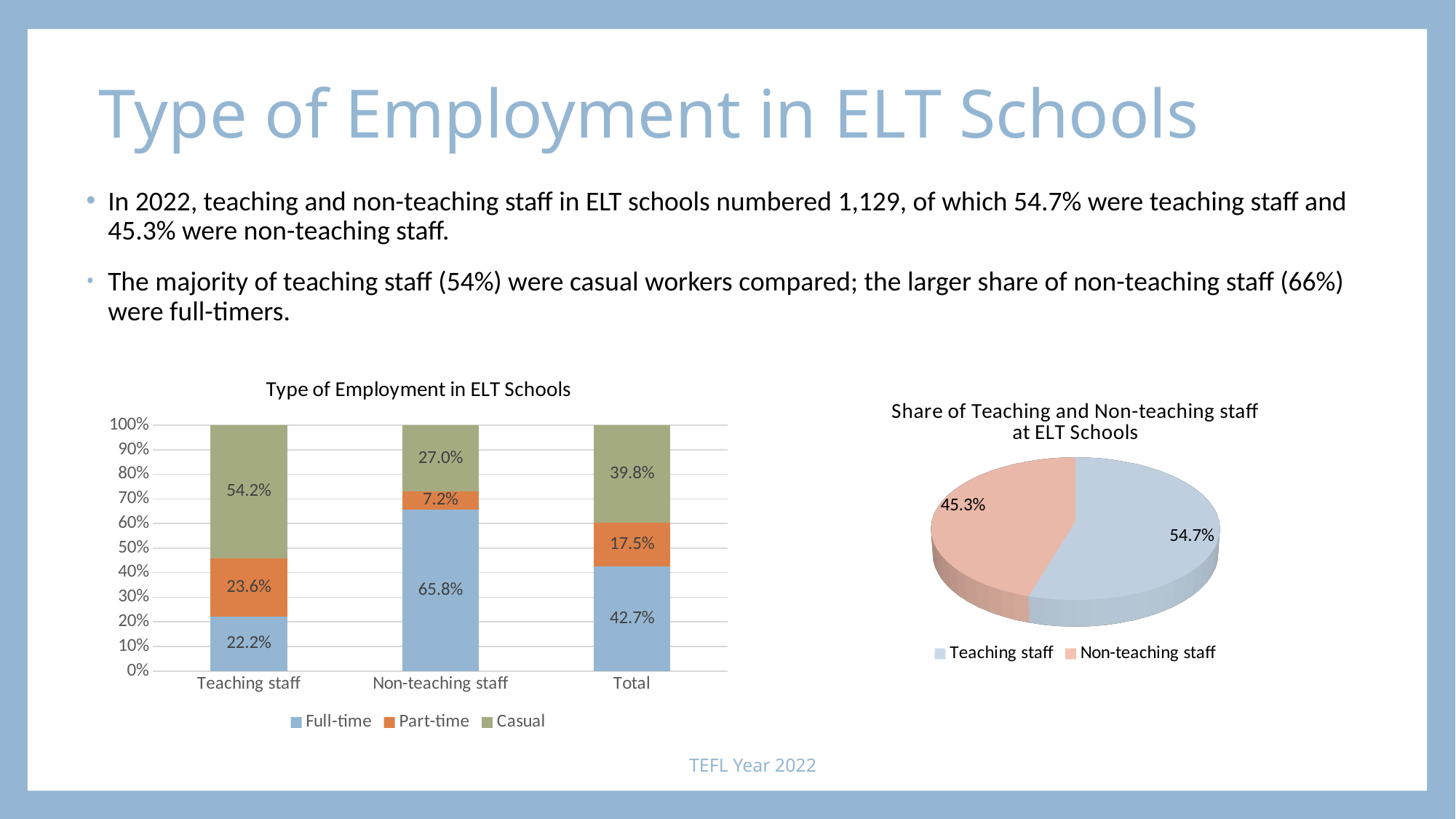
In the 'Type of Employment in ELT Schools' chart, what is the difference between the Casual share for Teaching staff and for Non-teaching staff? 27.2% What kind of chart is 'Share of Teaching and Non-teaching staff at ELT Schools'? Pie chart How many series does the legend of the 'Type of Employment in ELT Schools' chart list? 3 In the 'Type of Employment in ELT Schools' chart, what is the Part-time share for Total? 17.5% In the 'Share of Teaching and Non-teaching staff at ELT Schools' chart, what share is Non-teaching staff? 45.3% In the 'Type of Employment in ELT Schools' chart, what is the Full-time share for Non-teaching staff? 65.8% In the 'Type of Employment in ELT Schools' chart, which category has the highest Full-time share? Non-teaching staff In the 'Type of Employment in ELT Schools' chart, which category has the lowest Part-time share? Non-teaching staff How many categories are shown on the x axis of the 'Type of Employment in ELT Schools' chart? 3 In the 'Type of Employment in ELT Schools' chart, is the Full-time share larger for Teaching staff or for Total? Total In the 'Type of Employment in ELT Schools' chart, what is the Casual share for Teaching staff? 54.2% In the 'Share of Teaching and Non-teaching staff at ELT Schools' chart, which slice is larger? Teaching staff